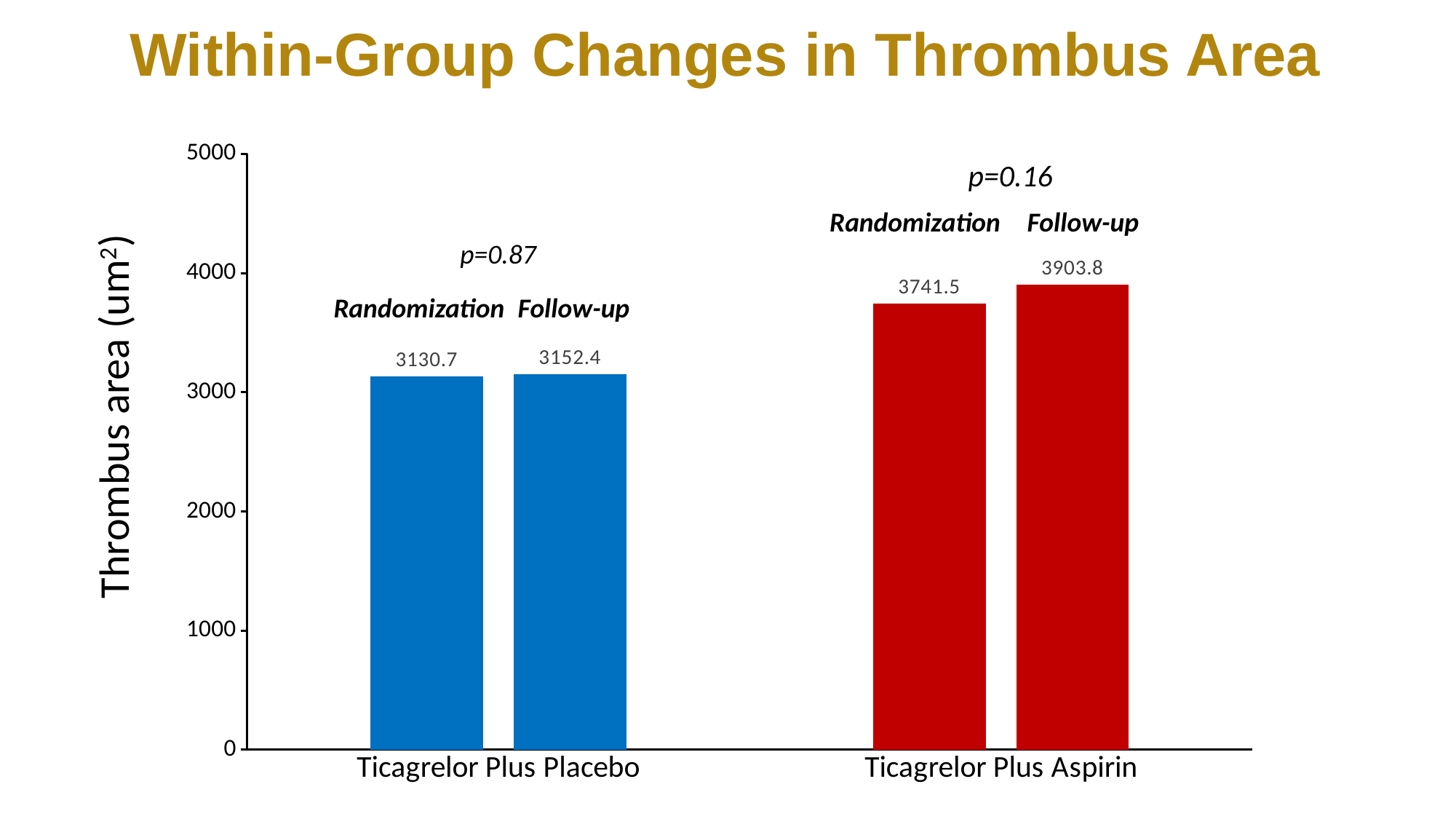
What is the thrombus area at Randomization for Ticagrelor Plus Placebo? 3130.7 What kind of chart is shown on the slide? Bar chart Is the Follow-up value for Ticagrelor Plus Aspirin greater or less than 4000? less Which is larger: the Randomization value for Ticagrelor Plus Aspirin or the Follow-up value for Ticagrelor Plus Placebo? Randomization value for Ticagrelor Plus Aspirin What is the thrombus area at Follow-up for Ticagrelor Plus Aspirin? 3903.8 Which bar has the lowest thrombus area? Ticagrelor Plus Placebo Randomization What p-value is shown for the Ticagrelor Plus Placebo group? p=0.87 What is the thrombus area at Follow-up for Ticagrelor Plus Placebo? 3152.4 Which bar has the highest thrombus area? Ticagrelor Plus Aspirin Follow-up How many bars are plotted on the chart? 4 What is the thrombus area at Randomization for Ticagrelor Plus Aspirin? 3741.5 What is the difference between the Follow-up and Randomization thrombus area for Ticagrelor Plus Aspirin? 162.3